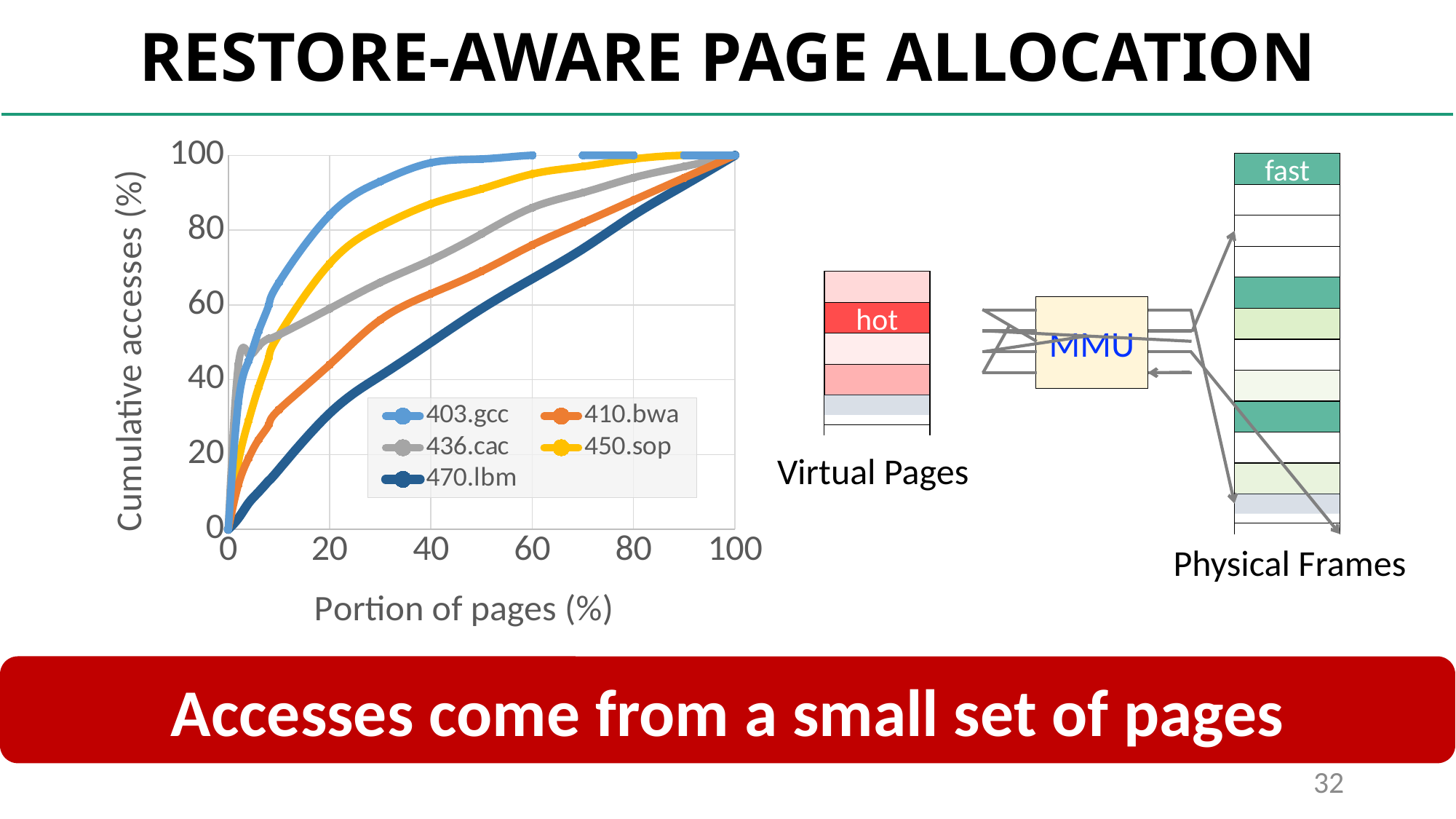
At 60% of pages, which series has higher cumulative accesses, 436.cac or 410.bwa? 436.cac Which series has the highest cumulative accesses at 20% of pages? 403.gcc Which series has the lowest cumulative accesses at 20% of pages? 470.lbm Is the cumulative accesses value for 403.gcc at 20% of pages greater or less than 80? greater How many series does the chart legend list? 5 Is the cumulative accesses value for 470.lbm at 20% of pages greater or less than 40? less Which series are listed in the chart legend? 403.gcc, 410.bwa, 436.cac, 450.sop, 470.lbm What is the title of the x axis of the chart? Portion of pages (%) Is the cumulative accesses value for 410.bwa at 20% of pages greater or less than 60? less What kind of chart is shown on the slide? line chart Do the cumulative accesses rise or fall as the portion of pages increases? rise